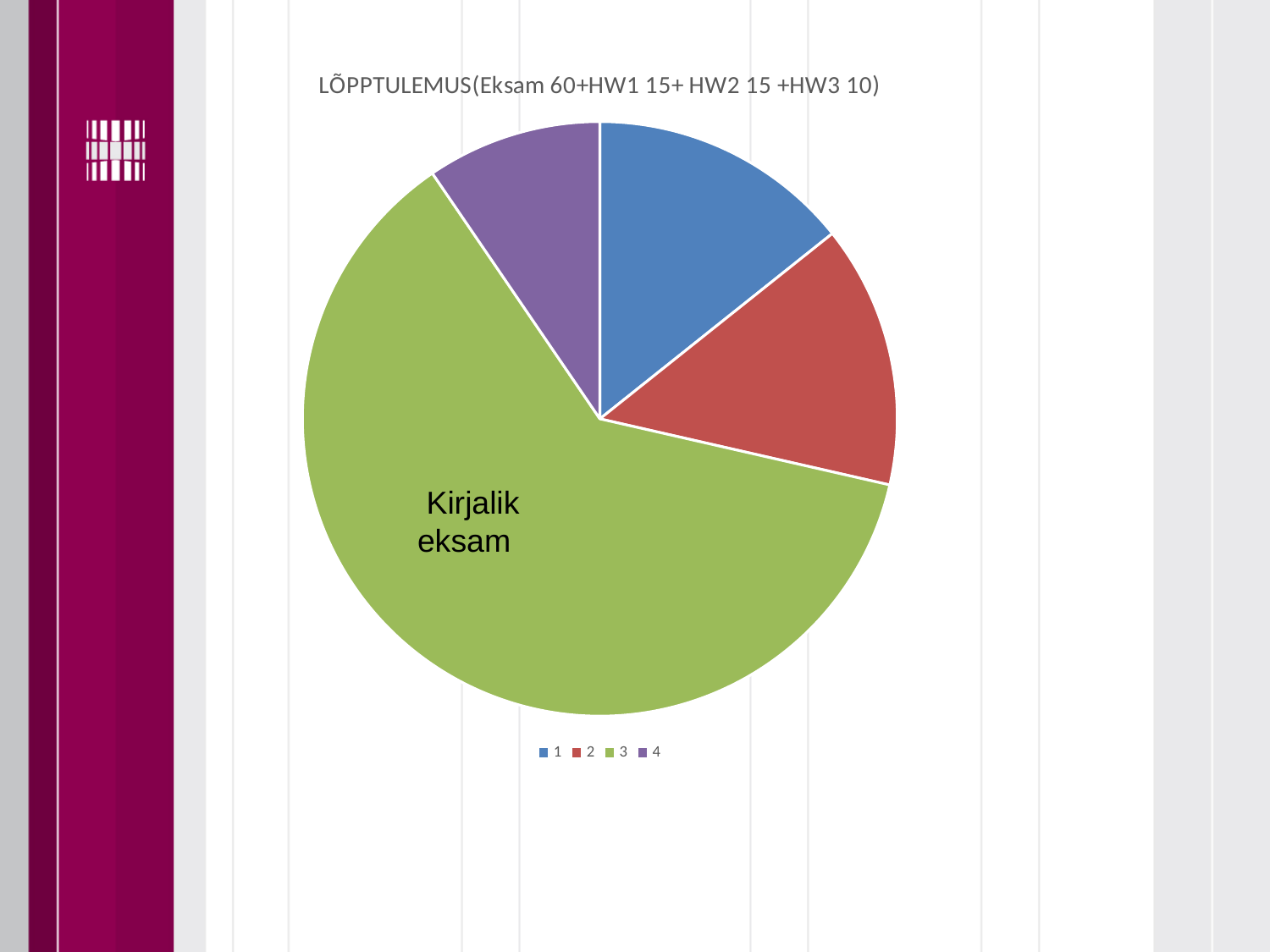
How many entries does the legend of the pie chart list? 4 Which slice is larger in the pie chart, category 4 or category 3? 3 Which slice is larger in the pie chart, category 3 or category 1? 3 How many slices does the pie chart have? 4 Which category has the largest slice in the pie chart? 3 What kind of chart is shown on the slide? pie chart Does the largest slice of the pie chart take up more or less than half of the pie? more Which category has the smallest slice in the pie chart? 4 What is the title of the pie chart? LÕPPTULEMUS(Eksam 60+HW1 15+ HW2 15 +HW3 10) Which slice is larger in the pie chart, category 1 or category 4? 1 What text label is written inside the largest slice of the pie chart? Kirjalik eksam